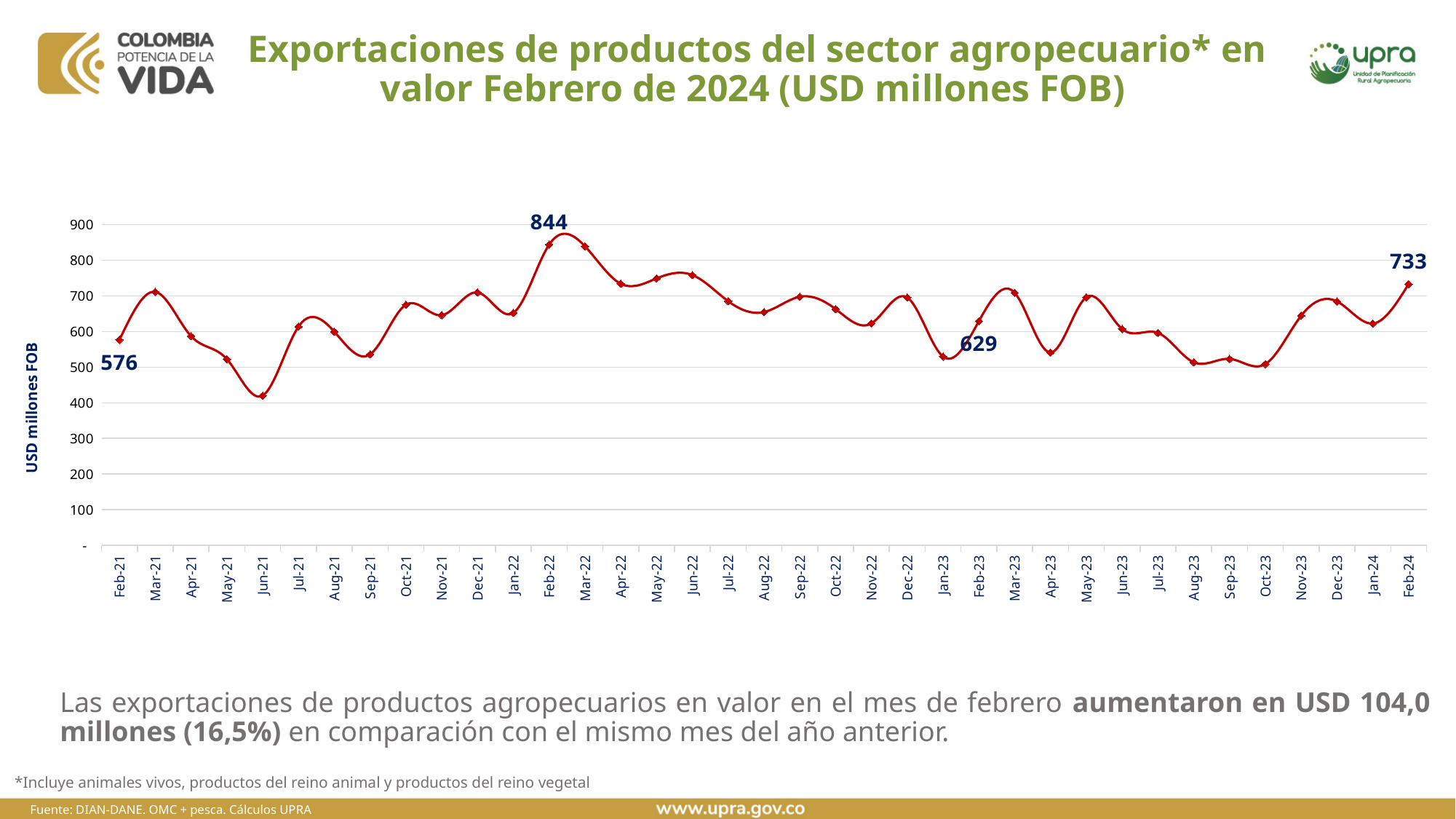
How many monthly data points are plotted on the chart? 37 What is the value for Feb-21? 576 What is the difference between the values for Feb-24 and Feb-23? 104 What kind of chart is shown on the slide? line chart What is the value for Feb-23? 629 Which month has the lowest value on the chart? Jun-21 What is the value for Feb-22? 844 What is the value for Feb-24? 733 Is the value for Jun-22 greater or less than 700? greater Is the value for Jun-21 greater or less than 500? less Which is larger, the value for Feb-22 or the value for Feb-24? Feb-22 Which month has the highest value on the chart? Feb-22